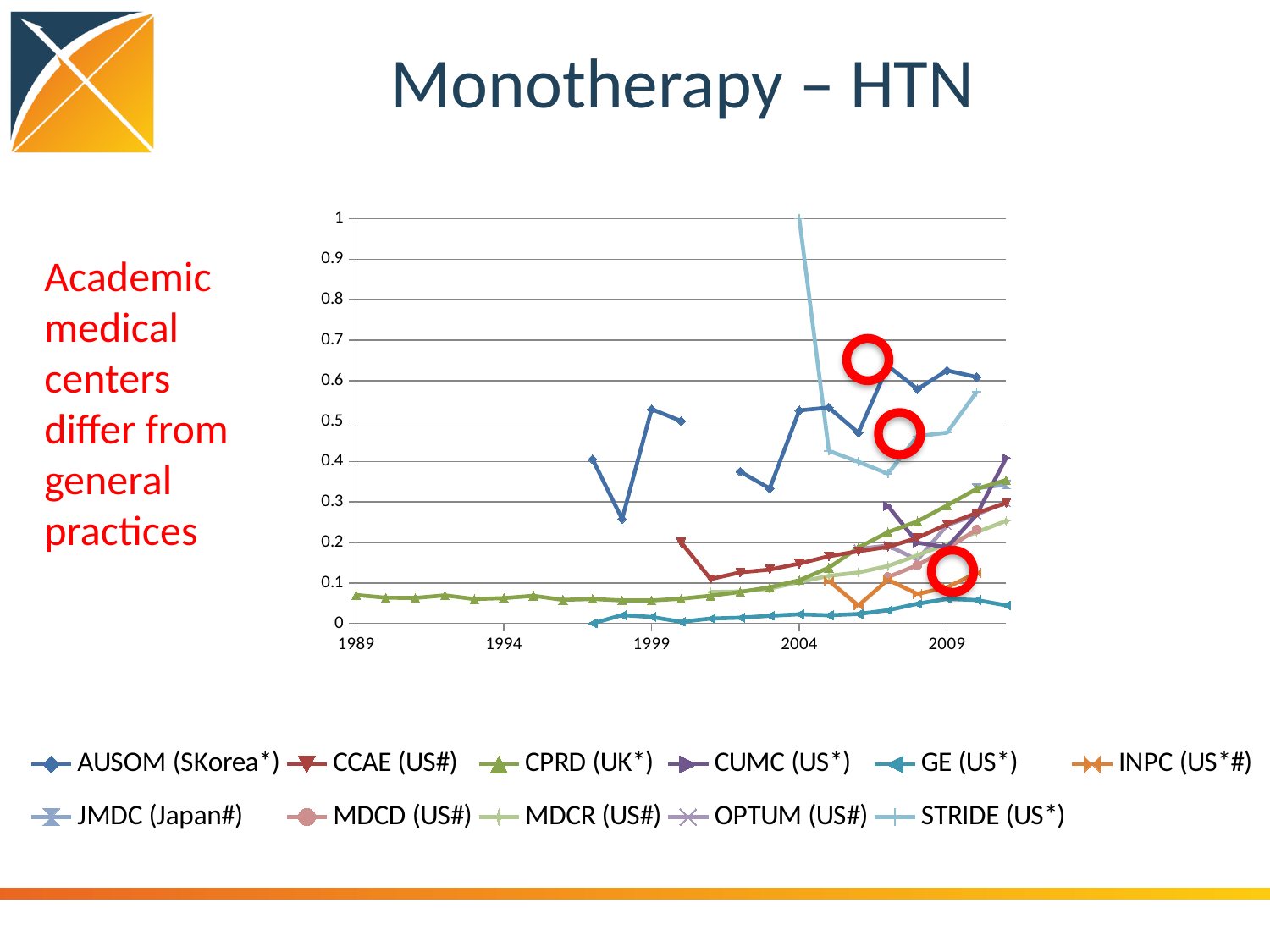
Is the value for AUSOM (SKorea*) in 2009 greater or less than 0.5? greater Is the value for CCAE (US#) in 2000 greater or less than 0.3? less Is the value for STRIDE (US*) in 2004 greater or less than 0.8? greater What is the title of the slide containing the chart? Monotherapy – HTN What kind of chart is shown on the slide? line chart Does the CPRD (UK*) series generally rise or fall from 1989 to the end of the chart? rise Which series is listed first in the legend? AUSOM (SKorea*) In 2009, which series has the larger value, AUSOM (SKorea*) or CPRD (UK*)? AUSOM (SKorea*) How many series does the legend list? 11 Which series reaches the highest value anywhere on the chart? STRIDE (US*)